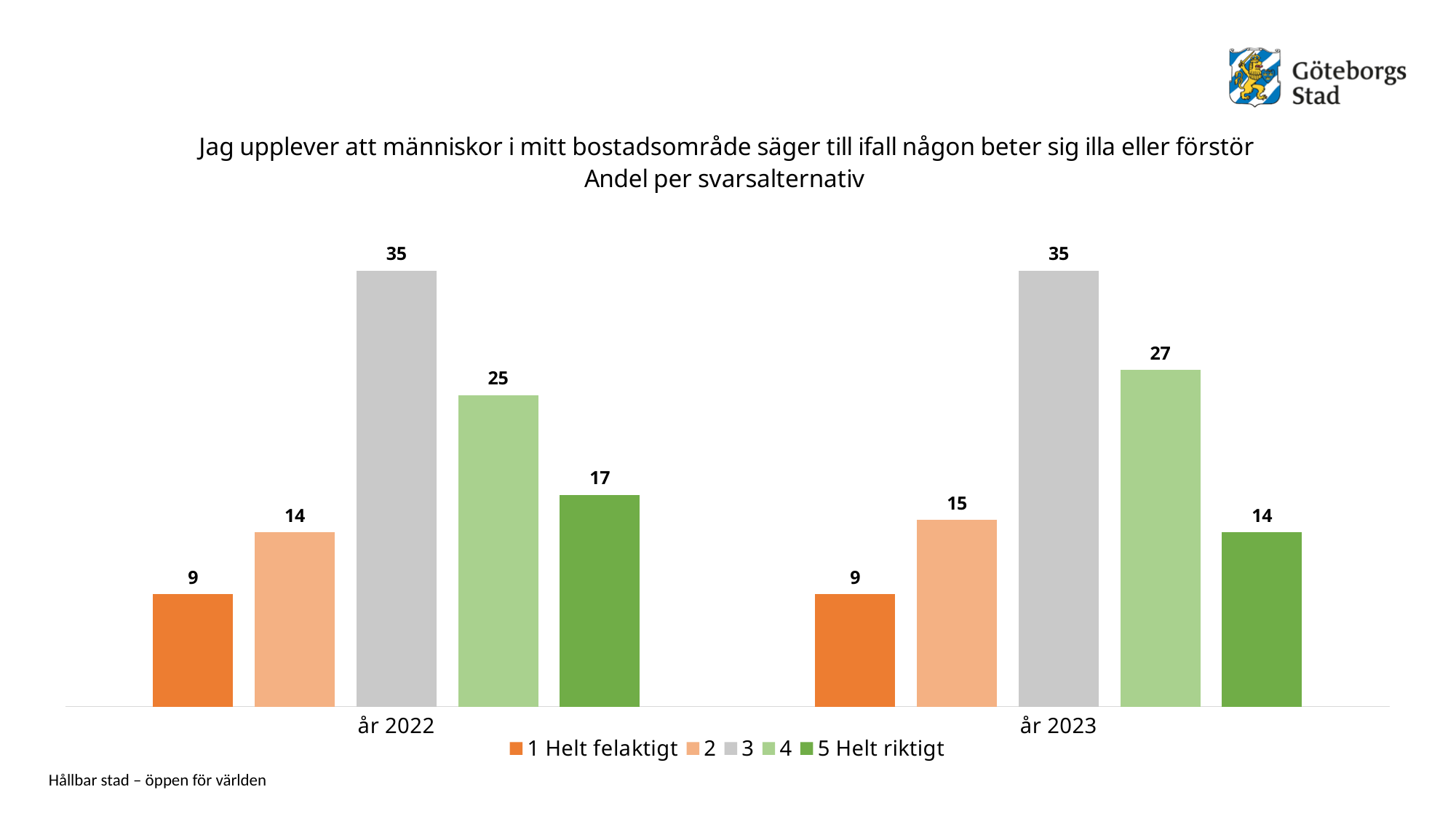
What is the value for series "3" in år 2022? 35 What is the difference between the value for series "4" in år 2023 and in år 2022? 2 Which is larger: the value for "5 Helt riktigt" in år 2022 or in år 2023? år 2022 What is the value for "5 Helt riktigt" in år 2022? 17 Which series has the lowest value in år 2022? 1 Helt felaktigt How many categories are shown on the x axis? 2 What colour are the bars for series "3"? grey What is the value for "1 Helt felaktigt" in år 2023? 9 How many series does the legend list? 5 What is the value for series "4" in år 2023? 27 Which series has the highest value in år 2023? 3 What kind of chart is shown on the slide? bar chart